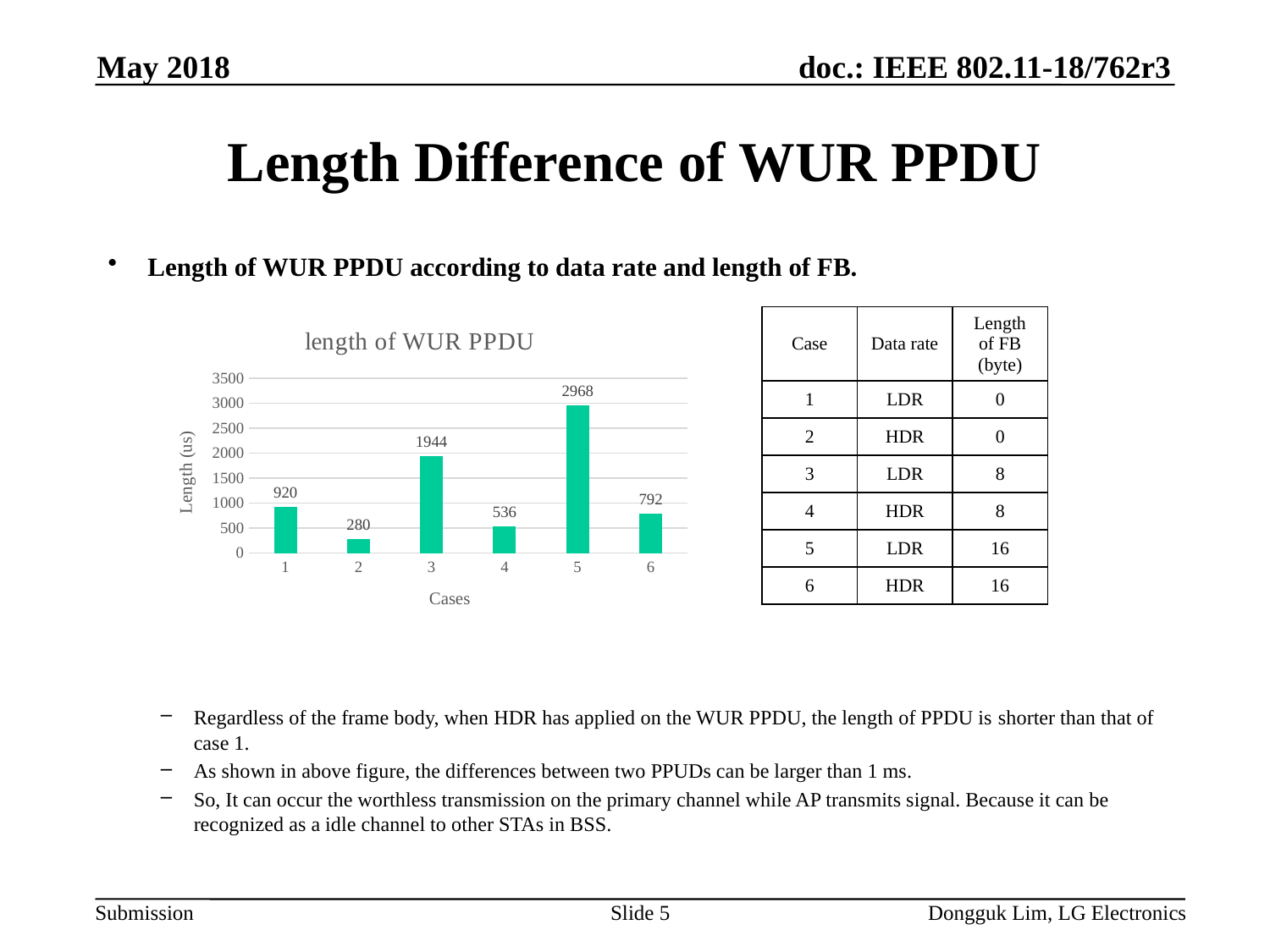
Which has a larger length of WUR PPDU, case 1 or case 4? case 1 What is the difference in length between case 5 and case 6? 2176 What is the length of WUR PPDU for case 3? 1944 Which case has the highest length of WUR PPDU? 5 What is the length of WUR PPDU for case 2? 280 What is the title of the chart? length of WUR PPDU What kind of chart is shown on the slide? bar chart What is the difference in length between case 1 and case 2? 640 Is the value for case 3 greater or less than 1500? greater Which case has the lowest length of WUR PPDU? 2 How many cases are plotted in the chart? 6 What is the length of WUR PPDU for case 5? 2968